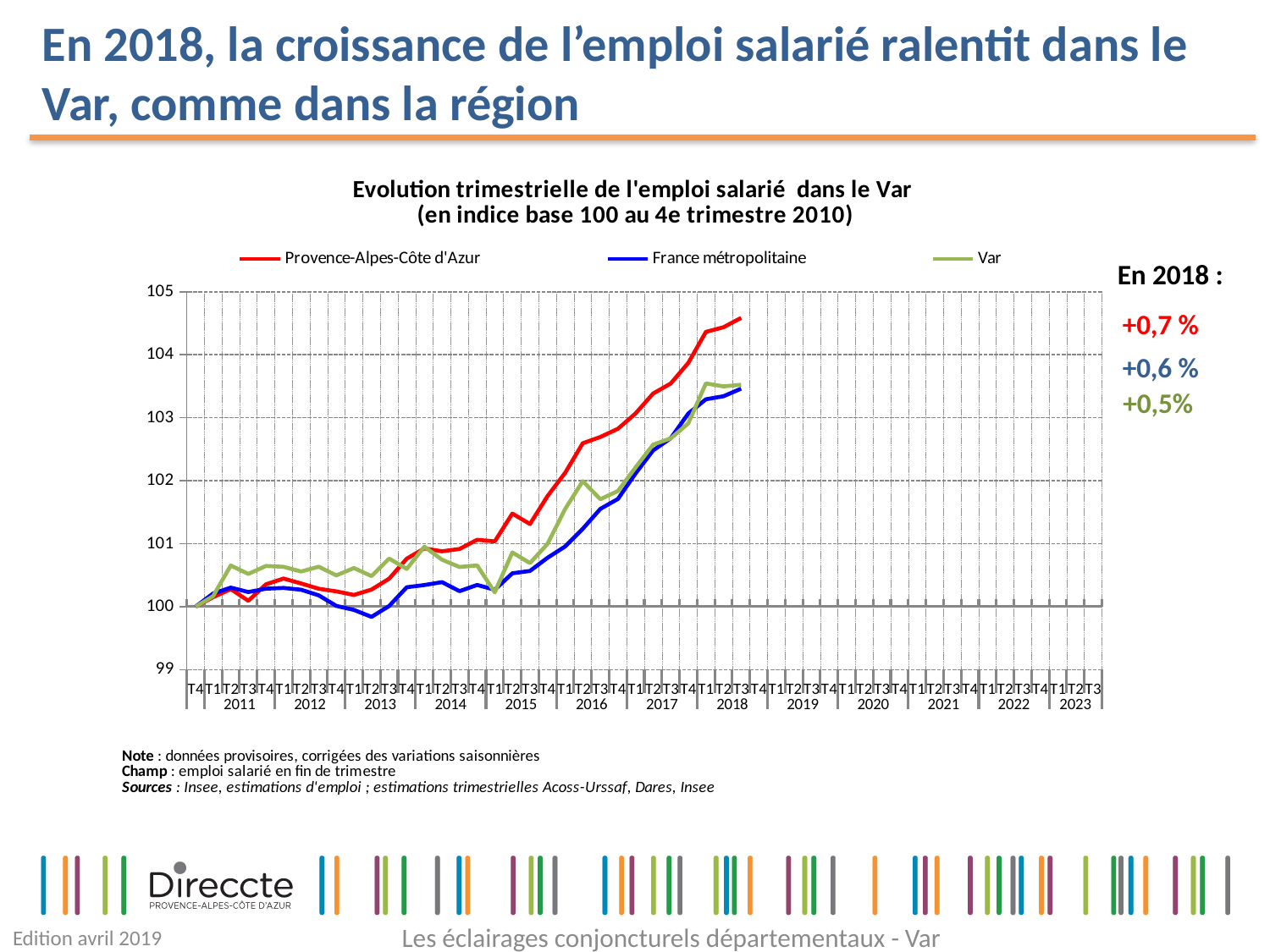
Which series has the lowest value at T2 2013? France métropolitaine Do the values for Provence-Alpes-Côte d'Azur generally rise or fall from 2013 to 2018? rise Is the value for Provence-Alpes-Côte d'Azur at T3 2018 greater or less than 104? greater Is the value for France métropolitaine at T2 2013 greater or less than 100? less Is the value for France métropolitaine at T3 2018 greater or less than 104? less Which series is drawn in red? Provence-Alpes-Côte d'Azur What kind of chart is shown on the slide? line chart How many series does the legend list? 3 Which series has the highest value at T3 2018? Provence-Alpes-Côte d'Azur At T2 2016, which is higher: Var or France métropolitaine? Var What is the title of the chart? Evolution trimestrielle de l'emploi salarié dans le Var (en indice base 100 au 4e trimestre 2010)